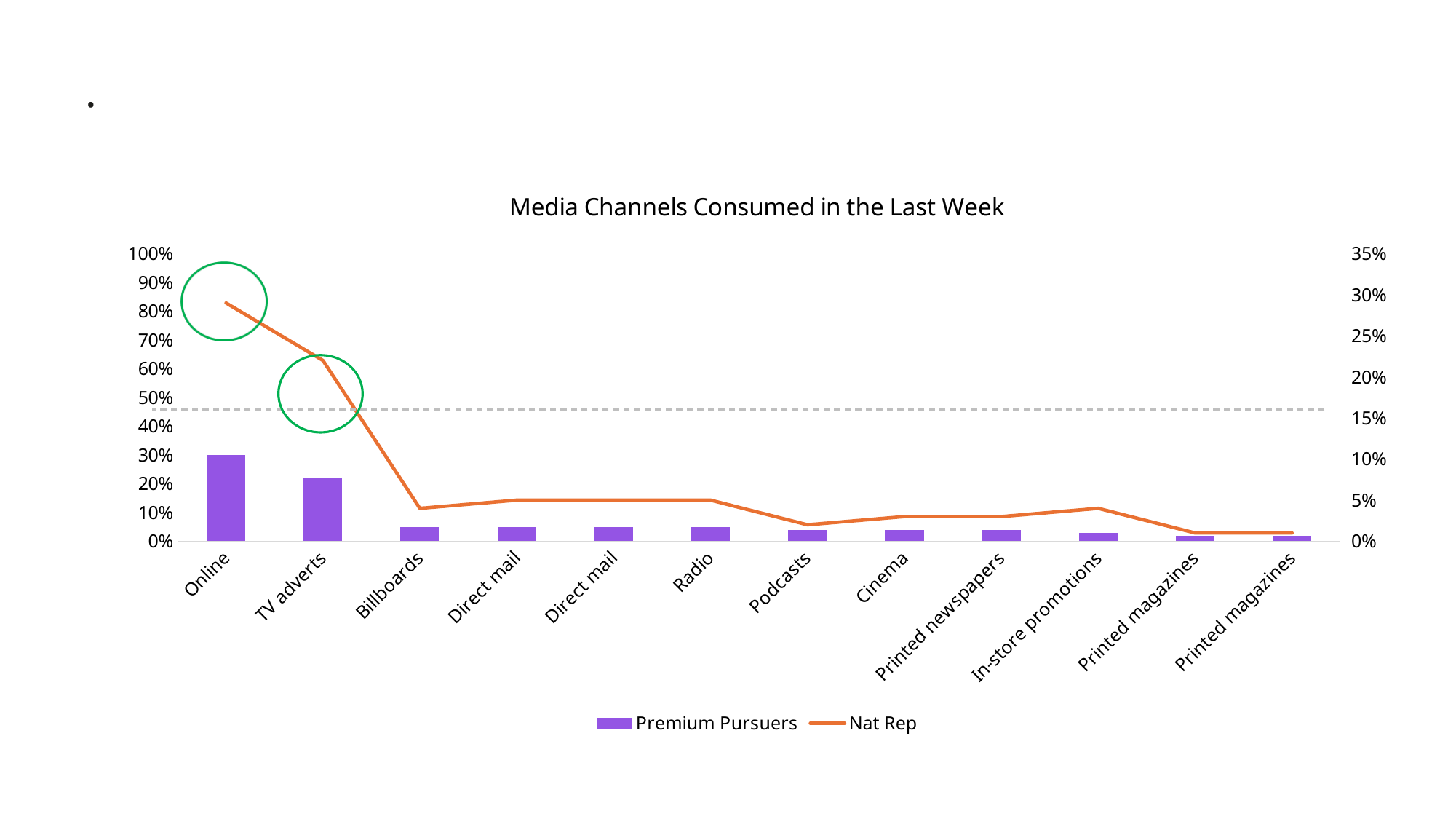
Is the Premium Pursuers value for Online greater or less than 20%? greater How many categories are shown on the x axis? 12 Which has the larger Premium Pursuers bar, Online or TV adverts? Online Is the Premium Pursuers value for TV adverts greater or less than 30%? less What is the title of the chart? Media Channels Consumed in the Last Week How many series does the legend list? 2 Which category has the highest Nat Rep value? Online Does the Nat Rep line generally rise or fall from left to right across the categories? Fall Which category has the lowest Premium Pursuers bar? Printed magazines Which category has the highest Premium Pursuers bar? Online Which series is drawn as a line? Nat Rep What kind of chart is shown on the slide? A combined bar and line chart